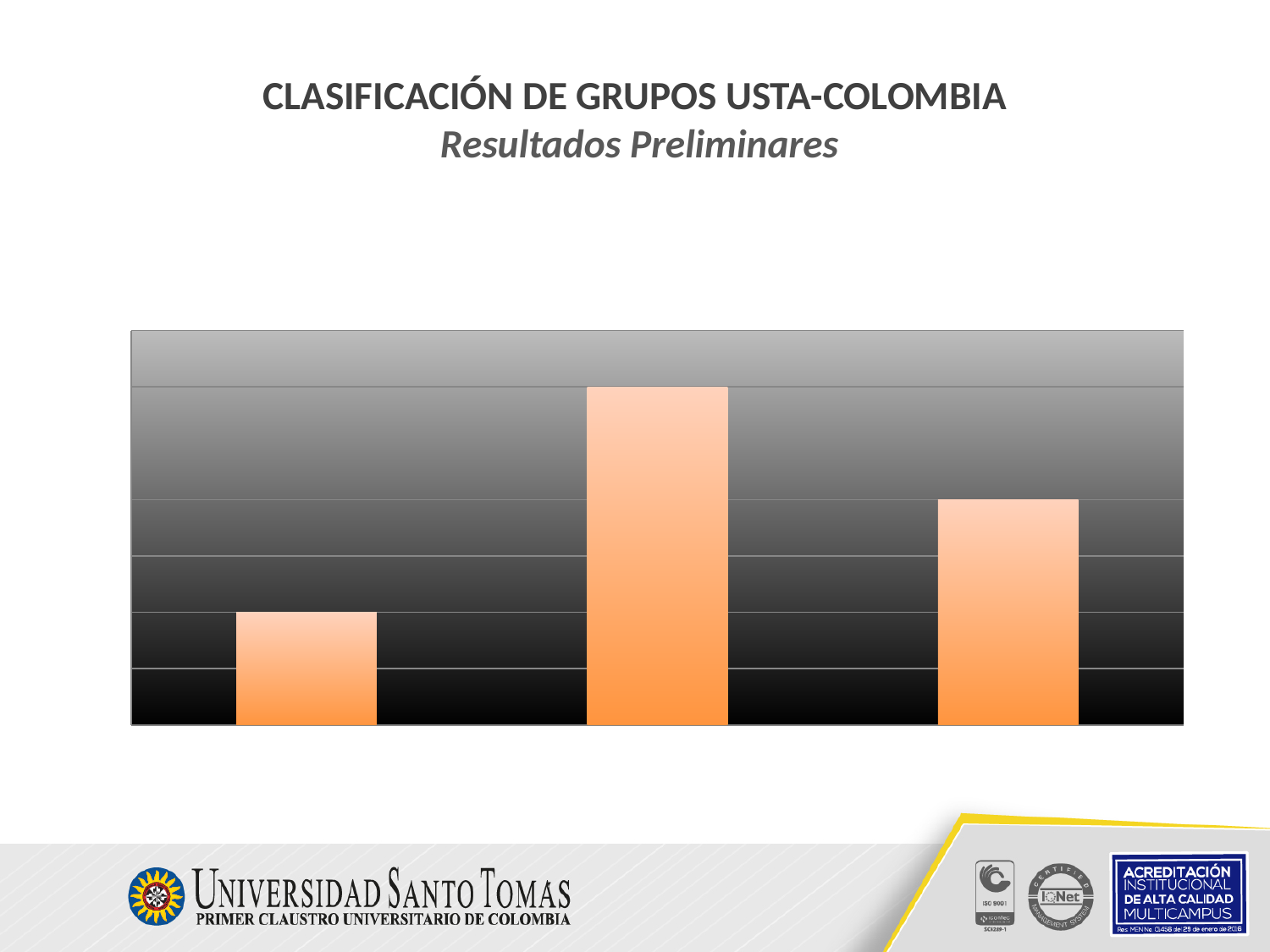
Is the right bar taller or shorter than the left bar? taller Is the left bar taller or shorter than the middle bar? shorter What kind of chart is shown on the slide? bar chart Which bar is the tallest in the chart: the left, middle or right one? middle What colour are the bars in the chart? orange Which bar is the shortest in the chart: the left, middle or right one? left Does the chart display a legend? No How many bars are plotted in the chart? 3 Is the middle bar taller or shorter than the right bar? taller